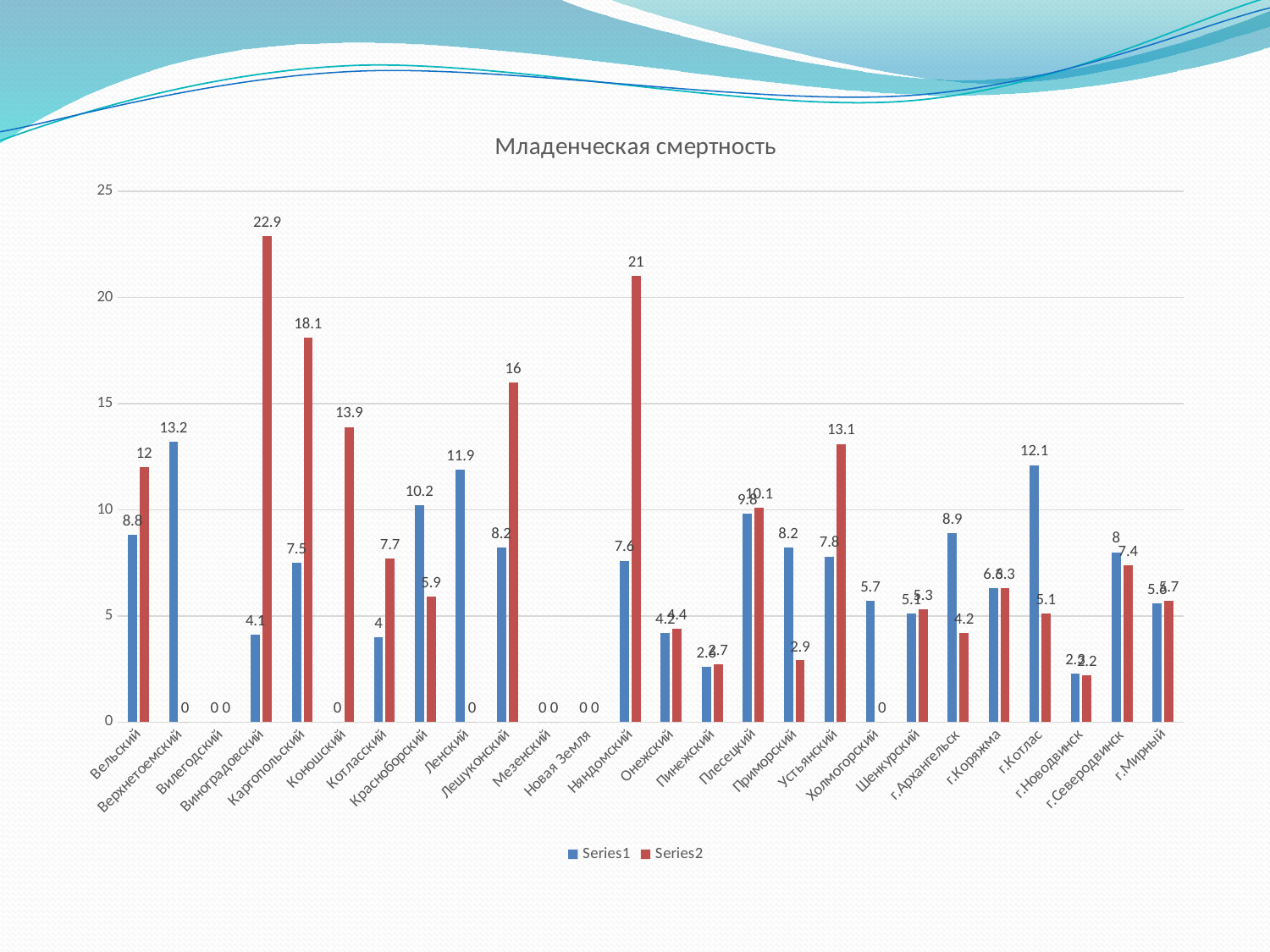
What is the Series2 value for Лешуконский? 16 What is the title of the chart? Младенческая смертность What kind of chart is shown on the slide? bar chart What is the difference between the Series2 and Series1 values for Няндомский? 13.4 Which is larger for Красноборский, the Series1 value or the Series2 value? Series1 What is the Series1 value for Верхнетоемский? 13.2 Which category has the highest Series1 value? Верхнетоемский What is the Series1 value for г.Котлас? 12.1 What is the Series2 value for Виноградовский? 22.9 How many series does the legend list? 2 Which category has the highest Series2 value? Виноградовский Is the Series2 value for Каргопольский greater or less than 15? greater